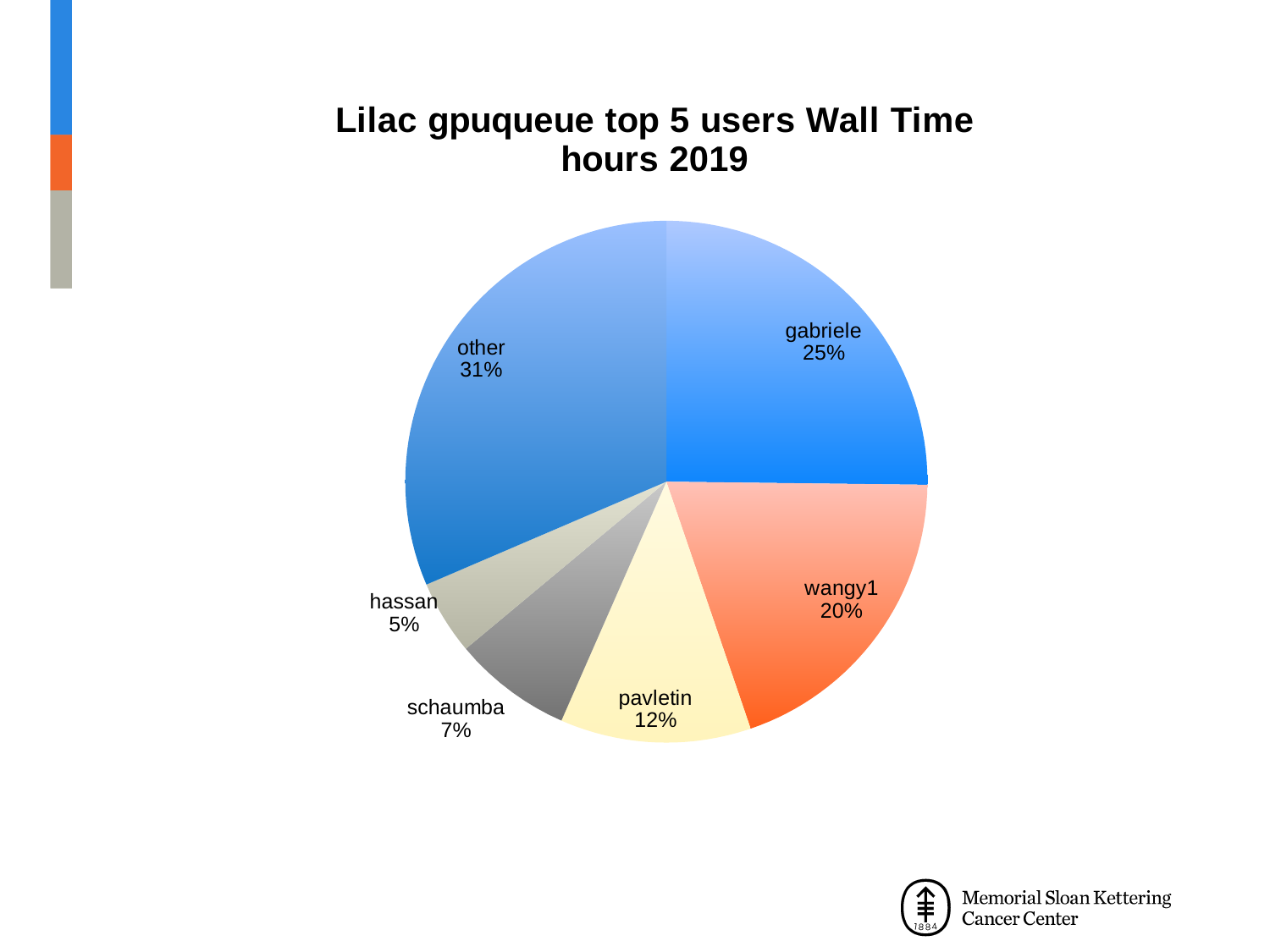
What share of the pie does gabriele have? 25% What is the difference in percentage points between gabriele and wangy1? 5 What percentage is shown for hassan? 5% Which slice has the largest share of the pie? other What percentage is shown for wangy1? 20% How many slices does the pie chart have? 6 Which named user has the smallest share of the pie? hassan What is the title of the chart? Lilac gpuqueue top 5 users Wall Time hours 2019 What percentage is shown for pavletin? 12% What share of the pie does schaumba have? 7% What kind of chart is shown on the slide? pie chart Which has a larger share, pavletin or schaumba? pavletin